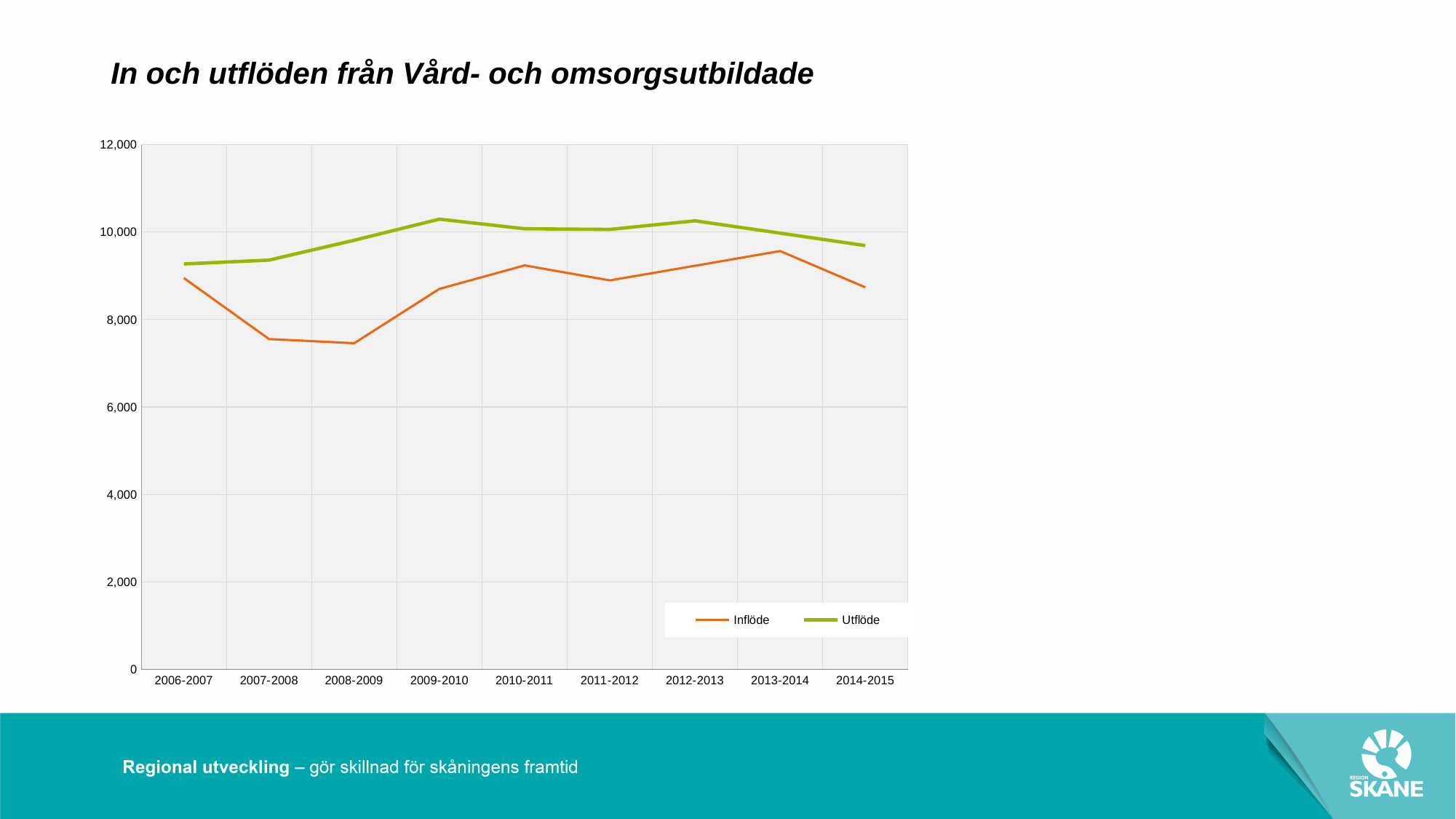
What kind of chart is shown on the slide? line chart Is the value for Utflöde in 2009-2010 greater or less than 10,000? greater Is the value for Utflöde in 2014-2015 greater or less than 10,000? less How many academic-year periods are shown on the x axis? 9 In which period does Inflöde reach its highest value? 2013-2014 Does the Inflöde line rise or fall from 2008-2009 to 2010-2011? rise In 2008-2009, which series has the larger value, Inflöde or Utflöde? Utflöde How many series does the legend list? 2 What is the title of the chart? In och utflöden från Vård- och omsorgsutbildade Which series is drawn in green? Utflöde Is the value for Inflöde in 2007-2008 greater or less than 8,000? less